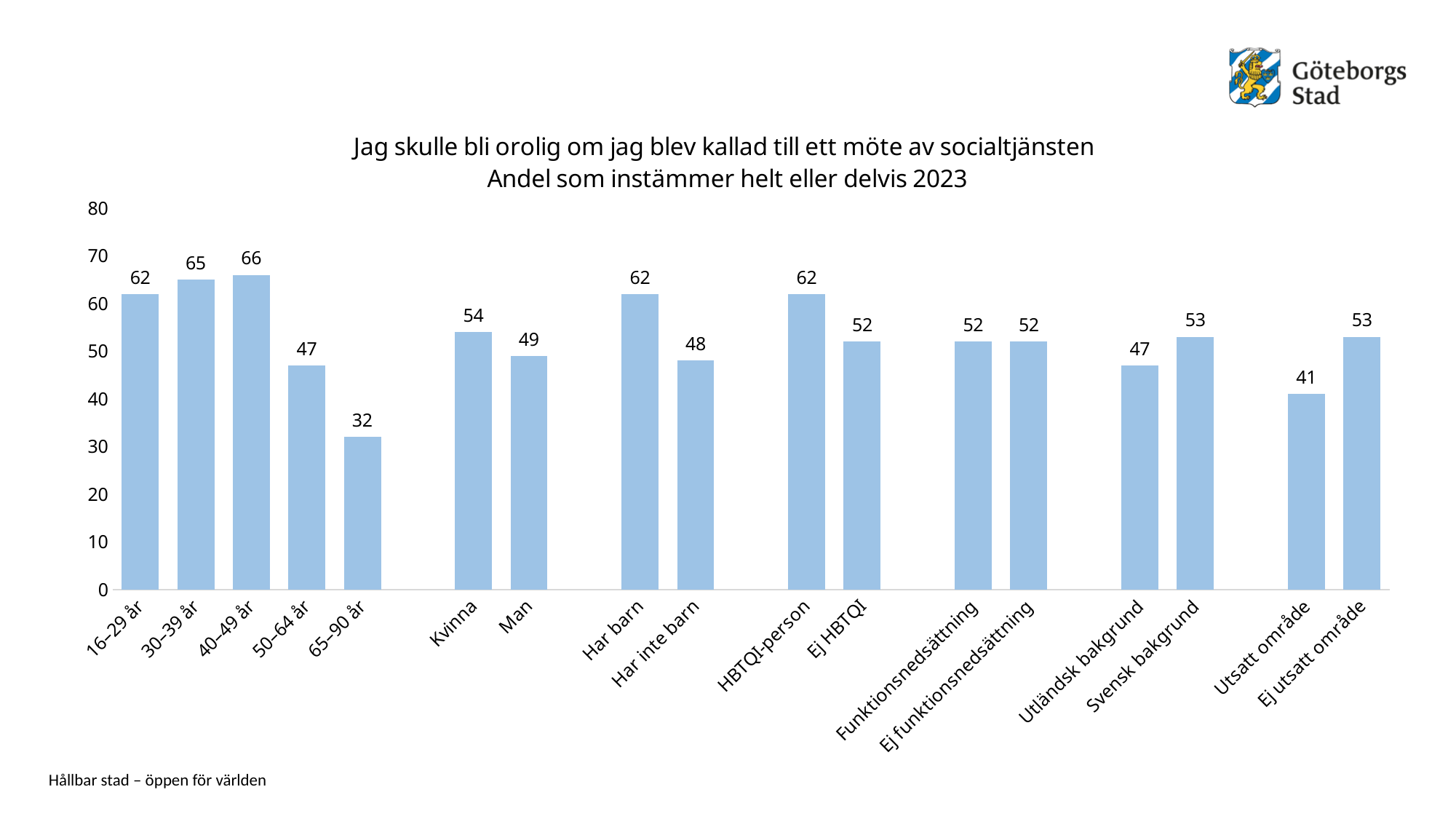
What is the value for 40–49 år? 66 Which is larger, the value for Kvinna or the value for Man? Kvinna What year is stated in the chart title? 2023 How many bars are shown in the chart? 17 Which category has the highest value? 40–49 år Which category has the lowest value? 65–90 år What is the difference between the values for Har barn and Har inte barn? 14 What is the difference between the values for 16–29 år and 65–90 år? 30 What is the value for Utsatt område? 41 What is the value for Kvinna? 54 What kind of chart is shown on the slide? Bar chart